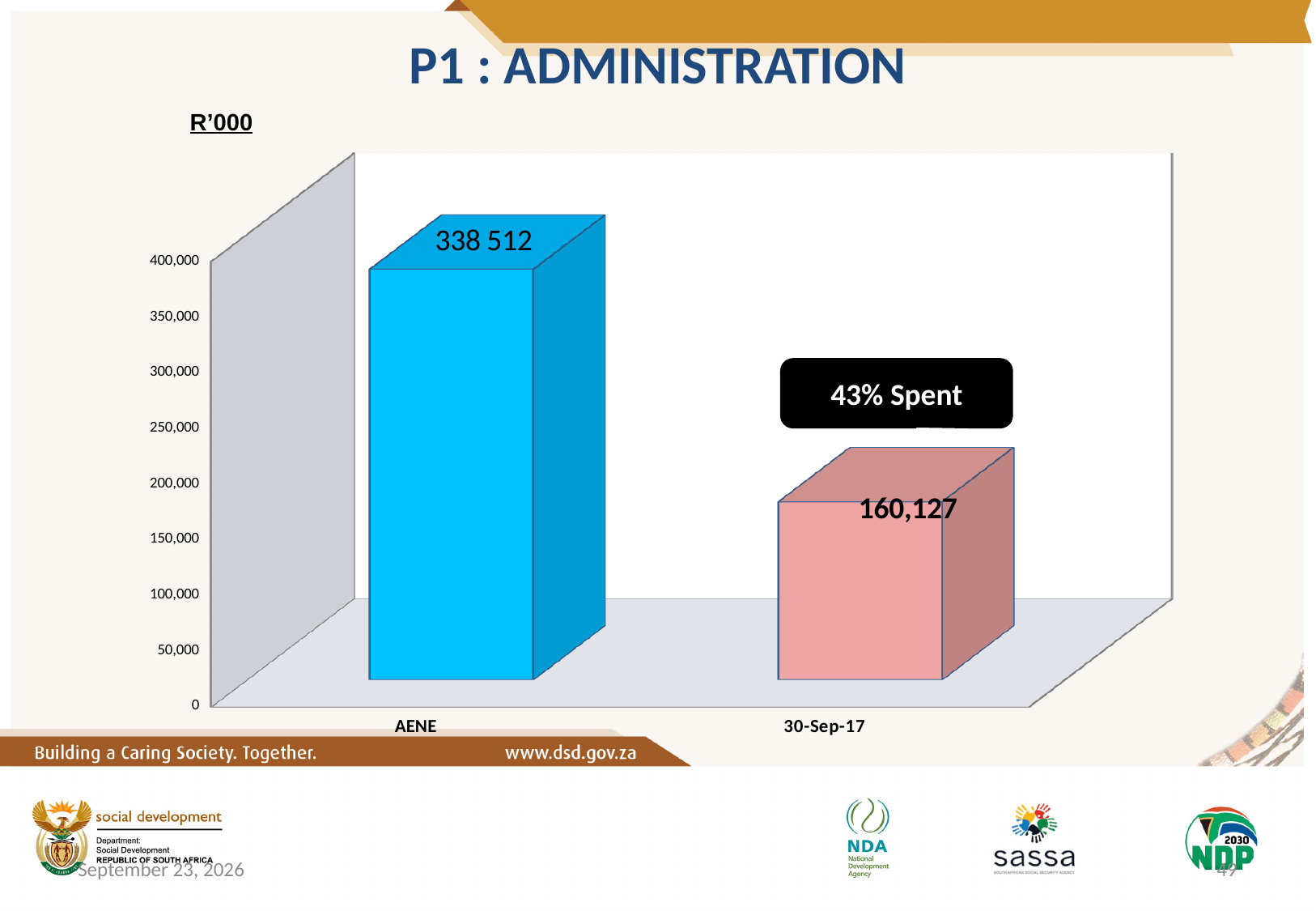
Which is larger, the value for AENE or the value for 30-Sep-17? AENE What is the value for 30-Sep-17? 160,127 What is the title of the slide containing the chart? P1 : ADMINISTRATION Is the value for AENE greater or less than 300,000? greater Is the value for 30-Sep-17 greater or less than 200,000? less What percentage spent is shown in the annotation on the chart? 43% Spent What kind of chart is shown on the slide? bar chart How many categories are shown on the x axis? 2 What is the value for AENE? 338 512 What is the difference between the AENE value and the 30-Sep-17 value? 178,385 Which category has the highest value? AENE Which category has the lowest value? 30-Sep-17